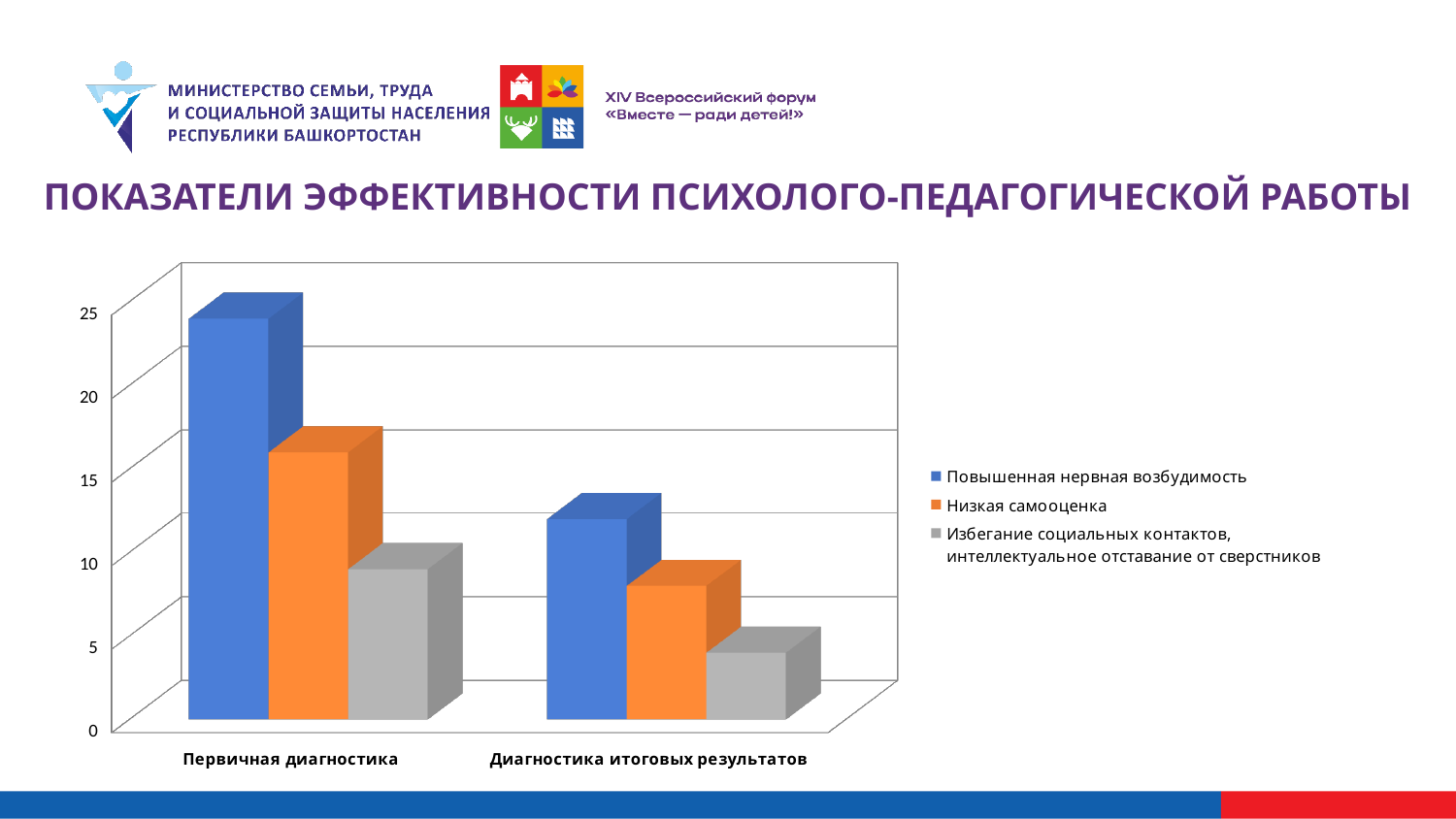
Which series has the lowest bar in the "Диагностика итоговых результатов" category? Избегание социальных контактов, интеллектуальное отставание от сверстников Is the value for "Низкая самооценка" in "Диагностика итоговых результатов" greater or less than 10? less Is the value for "Низкая самооценка" in "Первичная диагностика" greater or less than 10? greater What is the title of the slide above the chart? ПОКАЗАТЕЛИ ЭФФЕКТИВНОСТИ ПСИХОЛОГО-ПЕДАГОГИЧЕСКОЙ РАБОТЫ Is the value for "Повышенная нервная возбудимость" in "Первичная диагностика" greater or less than 20? greater Do the values for each series rise or fall from "Первичная диагностика" to "Диагностика итоговых результатов"? fall Which is larger: "Низкая самооценка" in "Первичная диагностика" or "Низкая самооценка" in "Диагностика итоговых результатов"? Первичная диагностика What kind of chart is shown on the slide? bar chart How many categories are shown on the x axis of the chart? 2 Which category has the highest bar for "Повышенная нервная возбудимость"? Первичная диагностика How many series does the chart legend list? 3